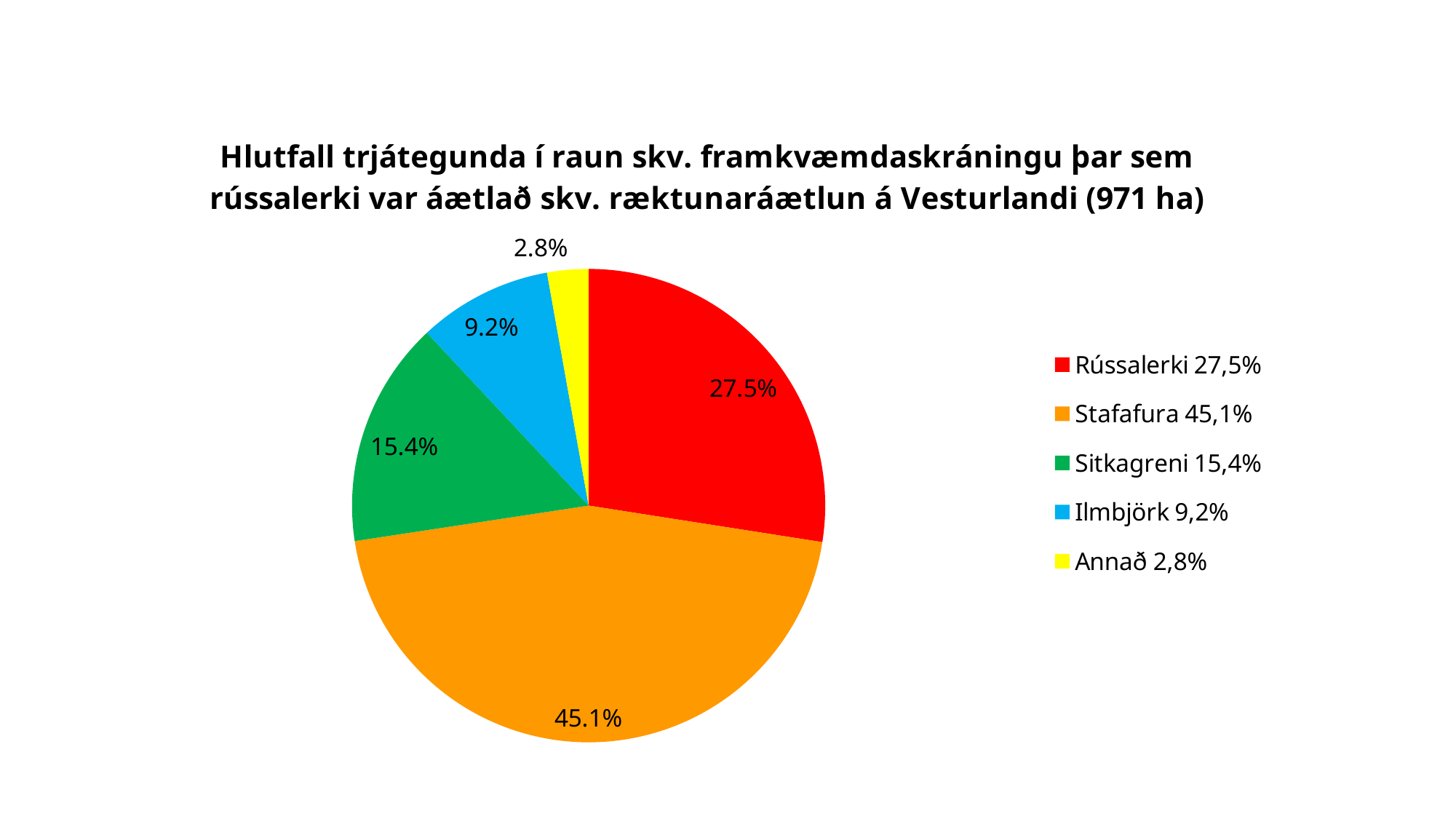
What is the difference in percentage points between Stafafura and Rússalerki? 17.6 What share of the pie does Sitkagreni have? 15.4% What colour is the slice for Ilmbjörk? blue Which is larger, the slice for Sitkagreni or the slice for Ilmbjörk? Sitkagreni Which tree species has the largest slice of the pie? Stafafura Which category has the smallest slice of the pie? Annað What share of the pie does Ilmbjörk have? 9.2% What kind of chart is shown on the slide? pie chart What share of the pie does Annað have? 2.8% How many slices does the pie chart have? 5